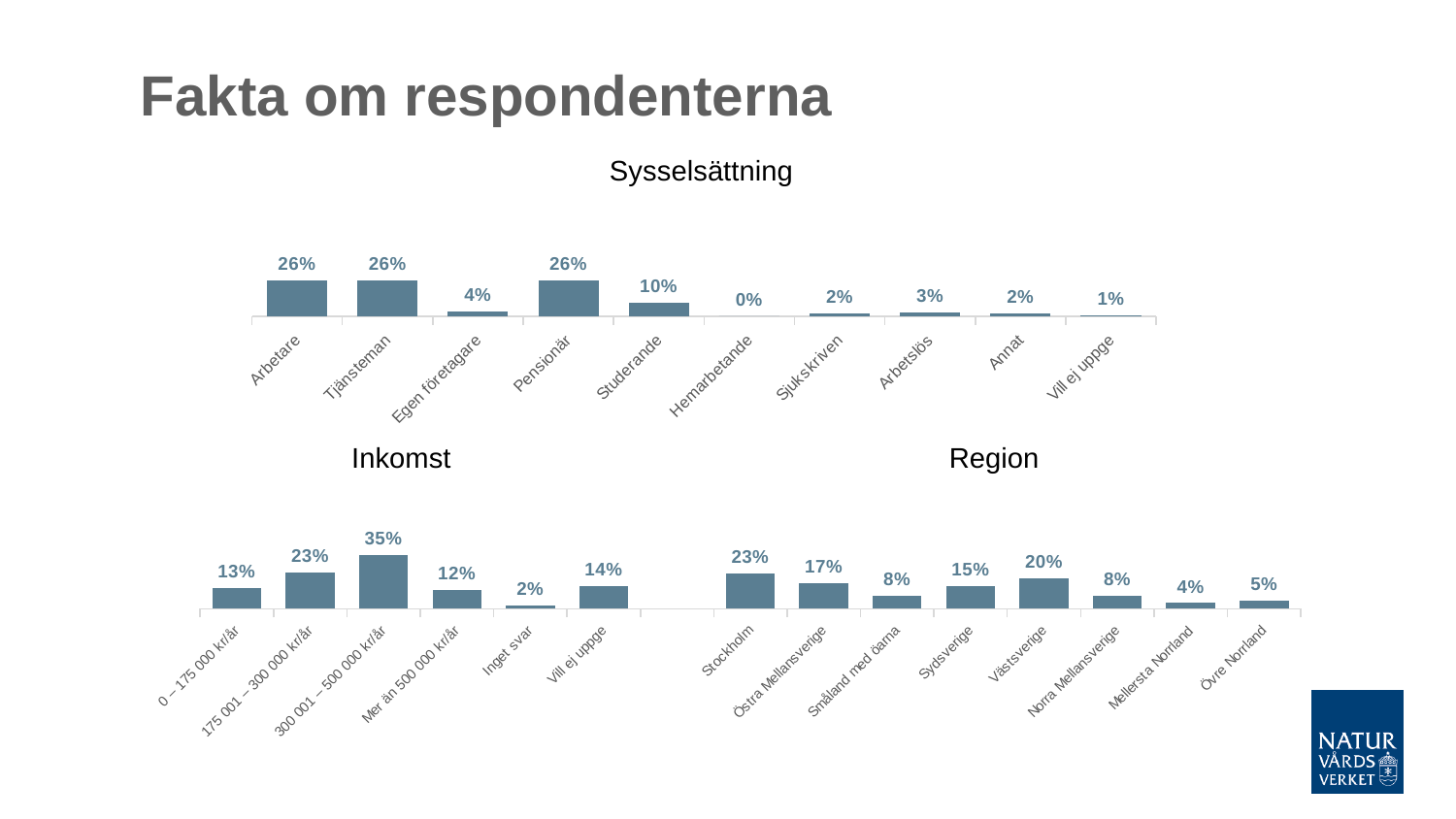
In the Sysselsättning chart, what is the value for Studerande? 10% In the Sysselsättning chart, how many categories are shown? 10 In the Region chart, which category has the highest value? Stockholm In the Inkomst chart, what is the difference between the values for 300 001 – 500 000 kr/år and 175 001 – 300 000 kr/år? 12% In the Inkomst chart, what is the value for Vill ej uppge? 14% In the Inkomst chart, which category has the lowest value? Inget svar What kind of chart is the Region chart? Bar chart In the Region chart, which is larger, the value for Östra Mellansverige or the value for Sydsverige? Östra Mellansverige In the Sysselsättning chart, what is the value for Hemarbetande? 0% In the Region chart, which category has the lowest value? Mellersta Norrland In the Region chart, how many categories are shown? 8 In the Inkomst chart, which category has the highest value? 300 001 – 500 000 kr/år